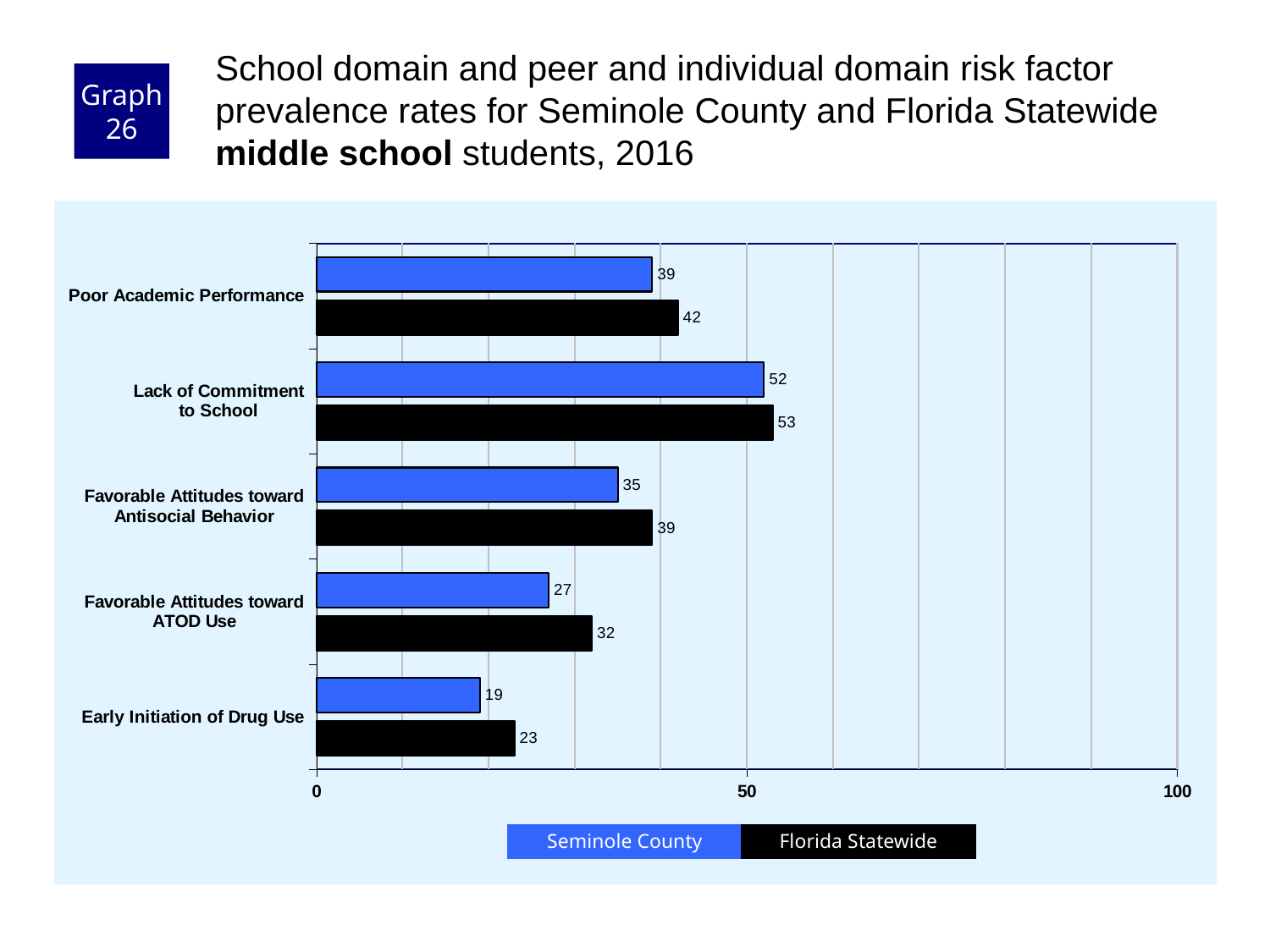
Which is larger for Favorable Attitudes toward Antisocial Behavior: the Seminole County value or the Florida Statewide value? Florida Statewide How many series does the legend list? 2 What is the difference between the Florida Statewide and Seminole County values for Favorable Attitudes toward ATOD Use? 5 How many risk factors are shown on the chart? 5 Which risk factor has the highest Florida Statewide value? Lack of Commitment to School What is the Florida Statewide value for Favorable Attitudes toward ATOD Use? 32 Is the Florida Statewide value for Lack of Commitment to School greater or less than 50? greater Which risk factor has the lowest Seminole County value? Early Initiation of Drug Use What is the Seminole County value for Lack of Commitment to School? 52 What is the difference between the Florida Statewide and Seminole County values for Poor Academic Performance? 3 What is the Seminole County value for Early Initiation of Drug Use? 19 What kind of chart is shown on the slide? bar chart